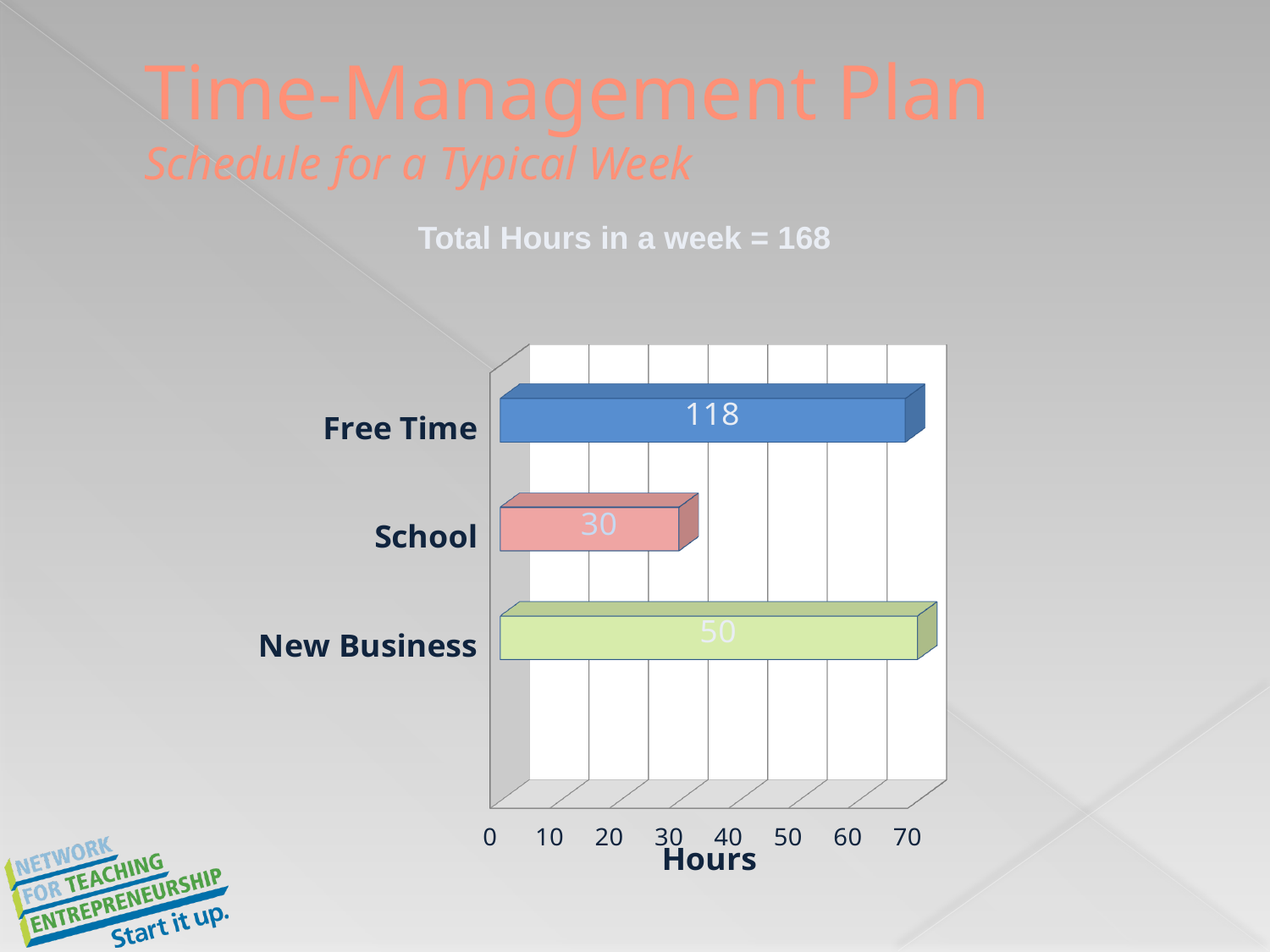
What kind of chart is shown on the slide? bar chart Which is larger, the value for School or the value for New Business? New Business What is the title of the horizontal axis? Hours Is the value for School greater or less than 40? less What value is shown for New Business? 50 How many categories are shown in the chart? 3 Which category has the lowest value? School What value is shown for Free Time? 118 What value is shown for School? 30